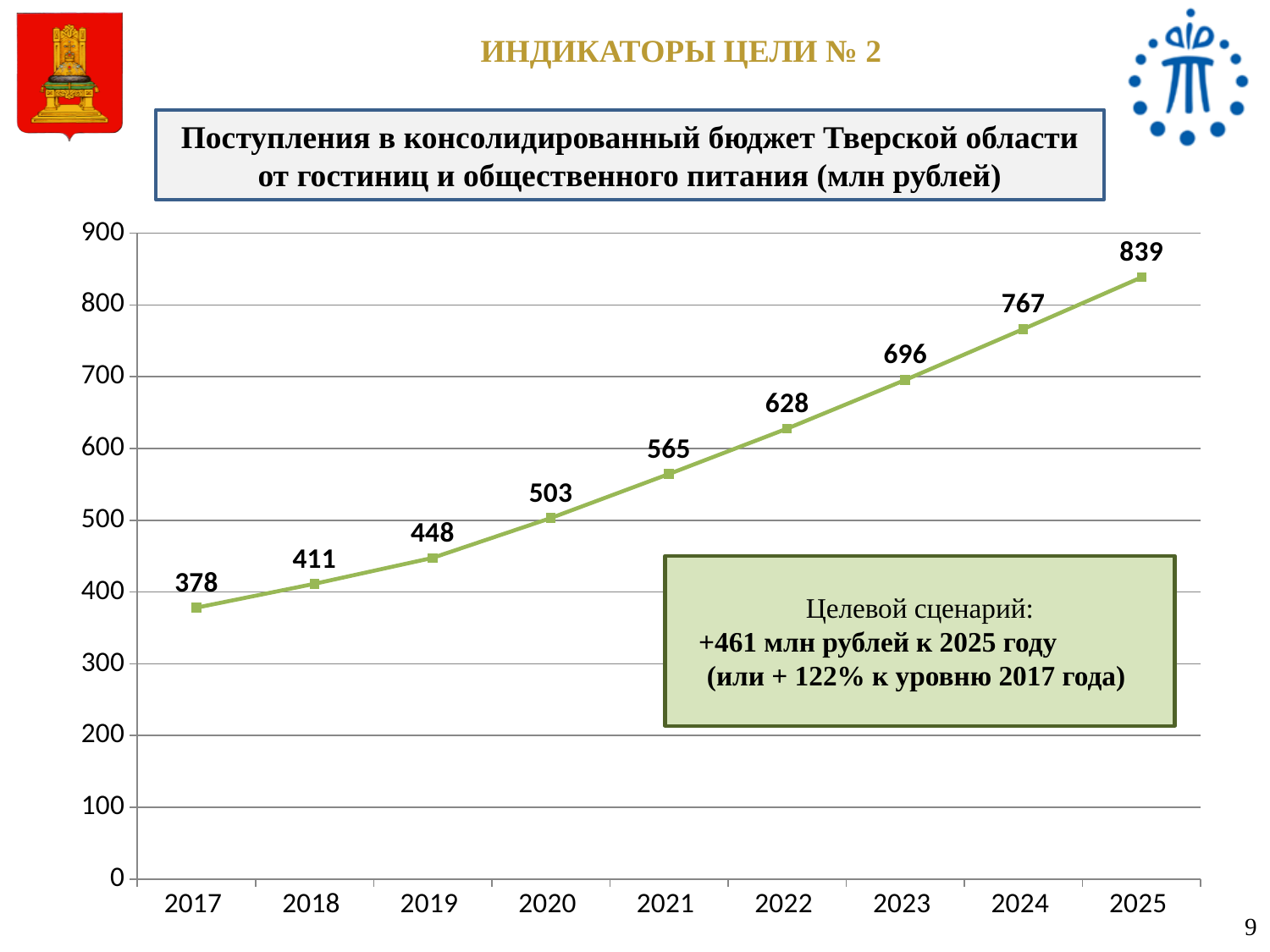
What is the difference between the values for 2025 and 2017? 461 Do the values rise or fall from 2017 to 2025? rise What is the value for 2017? 378 What is the difference between the values for 2023 and 2022? 68 What is the value for 2021? 565 Which year has the lowest value? 2017 Which year has the highest value? 2025 Which is larger, the value for 2020 or the value for 2019? 2020 Is the value for 2024 greater or less than 700? greater How many years are plotted on the chart? 9 What is the value for 2025? 839 What kind of chart is shown on the slide? line chart